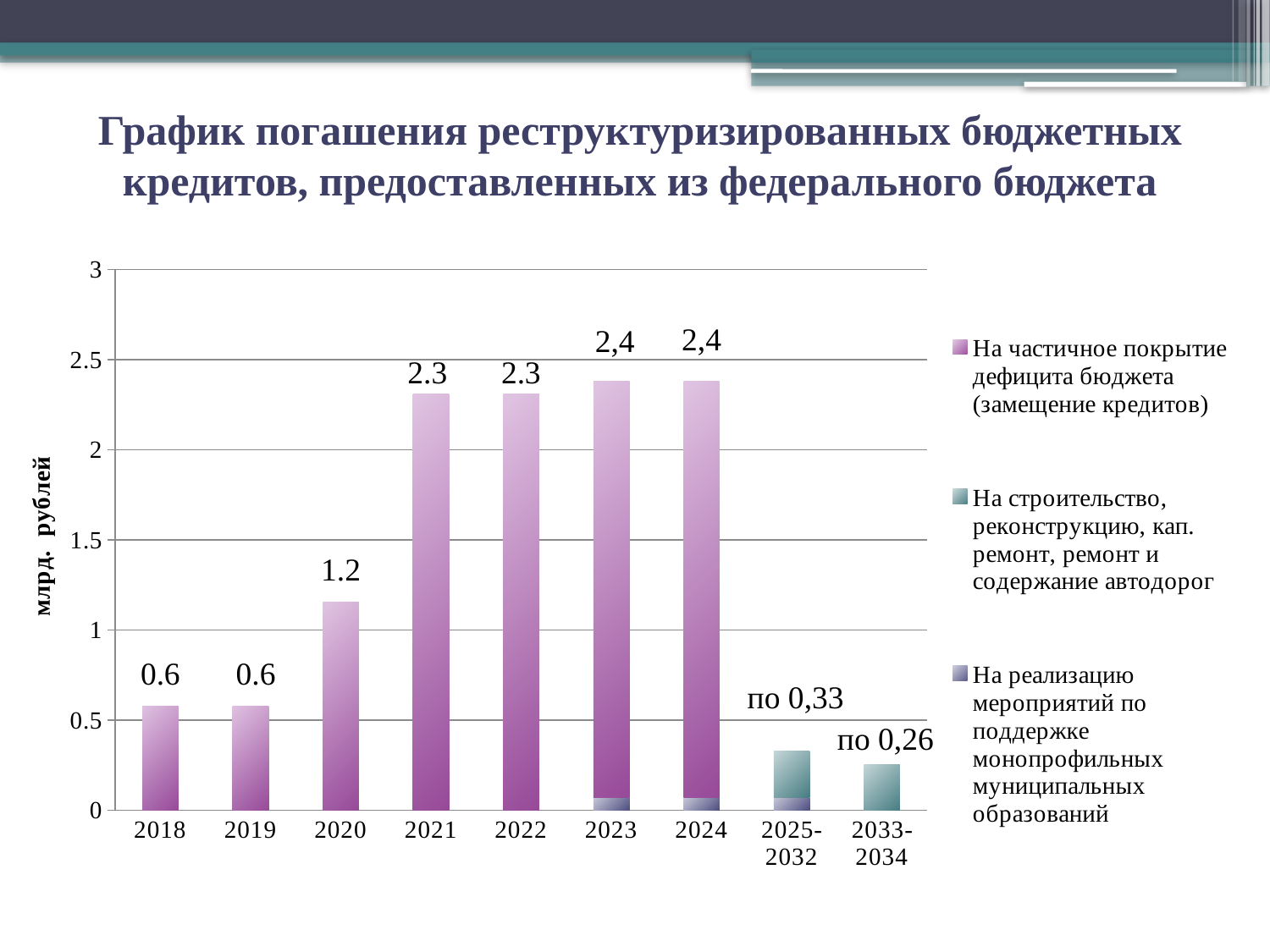
What is the value shown for 2020? 1.2 Which category has the lowest value? 2033-2034 What is the value labelled for 2023? 2,4 What is the difference between the values for 2021 and 2020? 1.1 How many categories are shown on the x axis? 9 What kind of chart is shown on the slide? bar chart What is the value labelled for the 2033-2034 period? по 0,26 Is the value for 2021 greater or less than 2? greater What is the label on the vertical axis? млрд. рублей What is the value labelled for the 2025-2032 period? по 0,33 How many series does the legend list? 3 Which is larger, the value for 2020 or the value for 2019? 2020